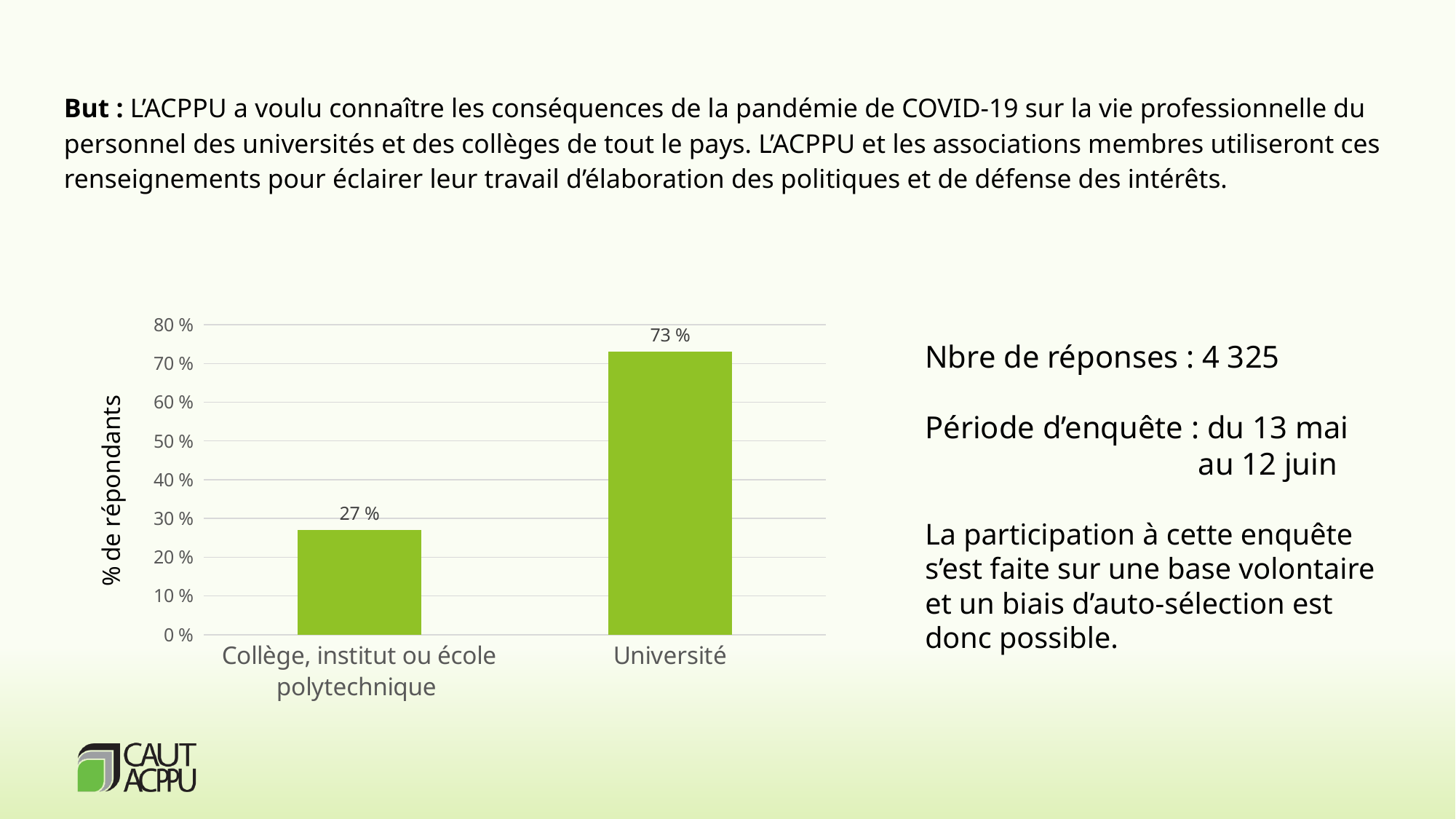
What is the value for Université? 73 % What kind of chart is shown on the slide? bar chart What is the value for Collège, institut ou école polytechnique? 27 % Is the value for Université greater or less than 70 %? greater What is the total of the two bar values? 100 % How many categories are shown on the x axis? 2 What is the difference between the values for Université and Collège, institut ou école polytechnique? 46 % Which is larger, the value for Université or the value for Collège, institut ou école polytechnique? Université Which category has the lowest value? Collège, institut ou école polytechnique Which category has the highest value? Université What is the label of the vertical axis? % de répondants Is the value for Collège, institut ou école polytechnique greater or less than 30 %? less